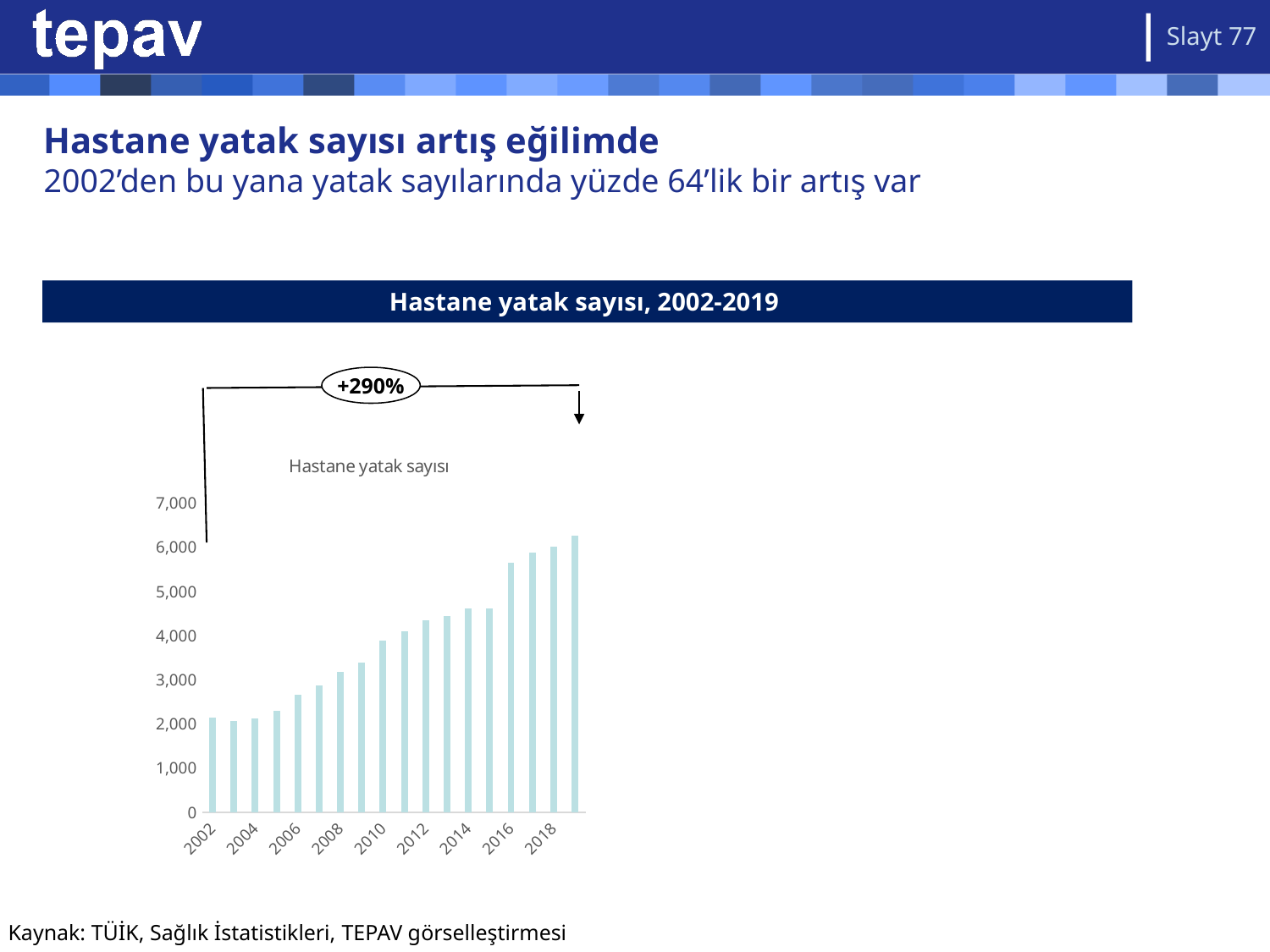
Which is larger, the value for 2016 or the value for 2014? 2016 Is the value for 2016 greater or less than 5,000? greater What kind of chart is shown on the slide? bar chart What percentage increase is shown in the annotation above the chart? +290% Is the value for 2006 greater or less than 3,000? less What is the title of the chart? Hastane yatak sayısı, 2002-2019 Is the value for 2019 greater or less than 6,000? greater Which is larger, the value for 2010 or the value for 2006? 2010 Do the values generally rise or fall from 2002 to 2019? rise Which year has the highest number of hospital beds? 2019 How many years (bars) are plotted in the chart? 18